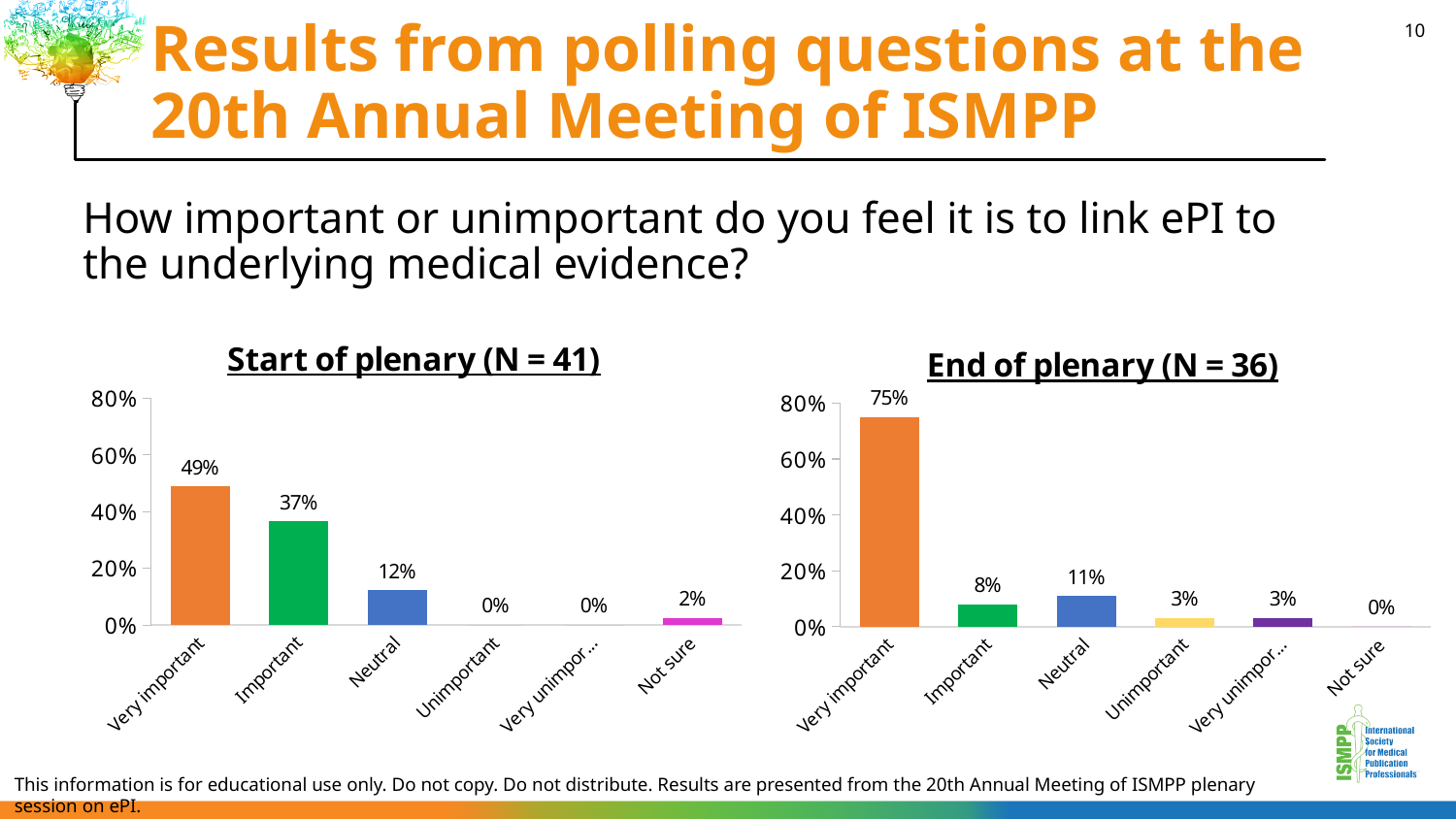
In the 'End of plenary (N = 36)' chart, what is the value for Important? 8% In the 'Start of plenary (N = 41)' chart, what is the value for Very important? 49% In the 'End of plenary (N = 36)' chart, which is larger, Important or Neutral? Neutral In the 'Start of plenary (N = 41)' chart, what is the difference between Very important and Important? 12% How many categories are shown on the x axis of the 'End of plenary (N = 36)' chart? 6 In the 'End of plenary (N = 36)' chart, what is the difference between Very important and Neutral? 64% In the 'Start of plenary (N = 41)' chart, is the value for Important greater or less than 40%? less What kind of chart is the 'Start of plenary (N = 41)' chart? Bar chart In the 'End of plenary (N = 36)' chart, which category has the highest value? Very important In the 'End of plenary (N = 36)' chart, what is the value for Very important? 75% In the 'Start of plenary (N = 41)' chart, what is the value for Neutral? 12% In the 'Start of plenary (N = 41)' chart, which category has the highest value? Very important